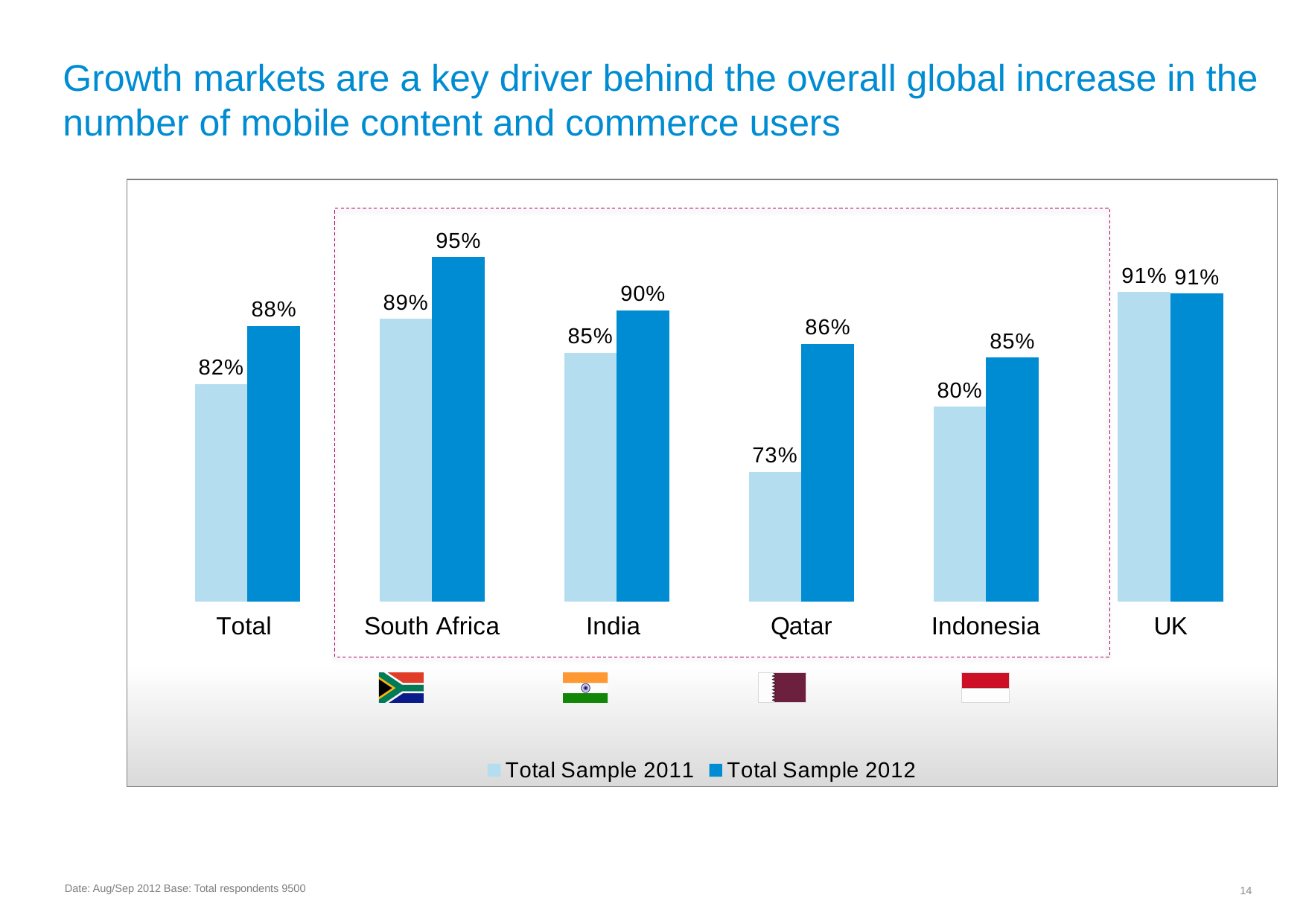
Which category has the lowest Total Sample 2011 value? Qatar What is the difference between the Total Sample 2012 values for South Africa and India? 5% How many categories are shown on the x axis? 6 What is the Total Sample 2011 value for Qatar? 73% How many series does the legend list? 2 What is the difference between the Total Sample 2012 and Total Sample 2011 values for Qatar? 13% What is the Total Sample 2012 value for Indonesia? 85% Which is larger: the Total Sample 2011 value for India or the Total Sample 2011 value for Indonesia? India What kind of chart is shown on the slide? Bar chart Which category has the highest Total Sample 2012 value? South Africa What are the two series named in the legend? Total Sample 2011 and Total Sample 2012 What is the Total Sample 2012 value for South Africa? 95%